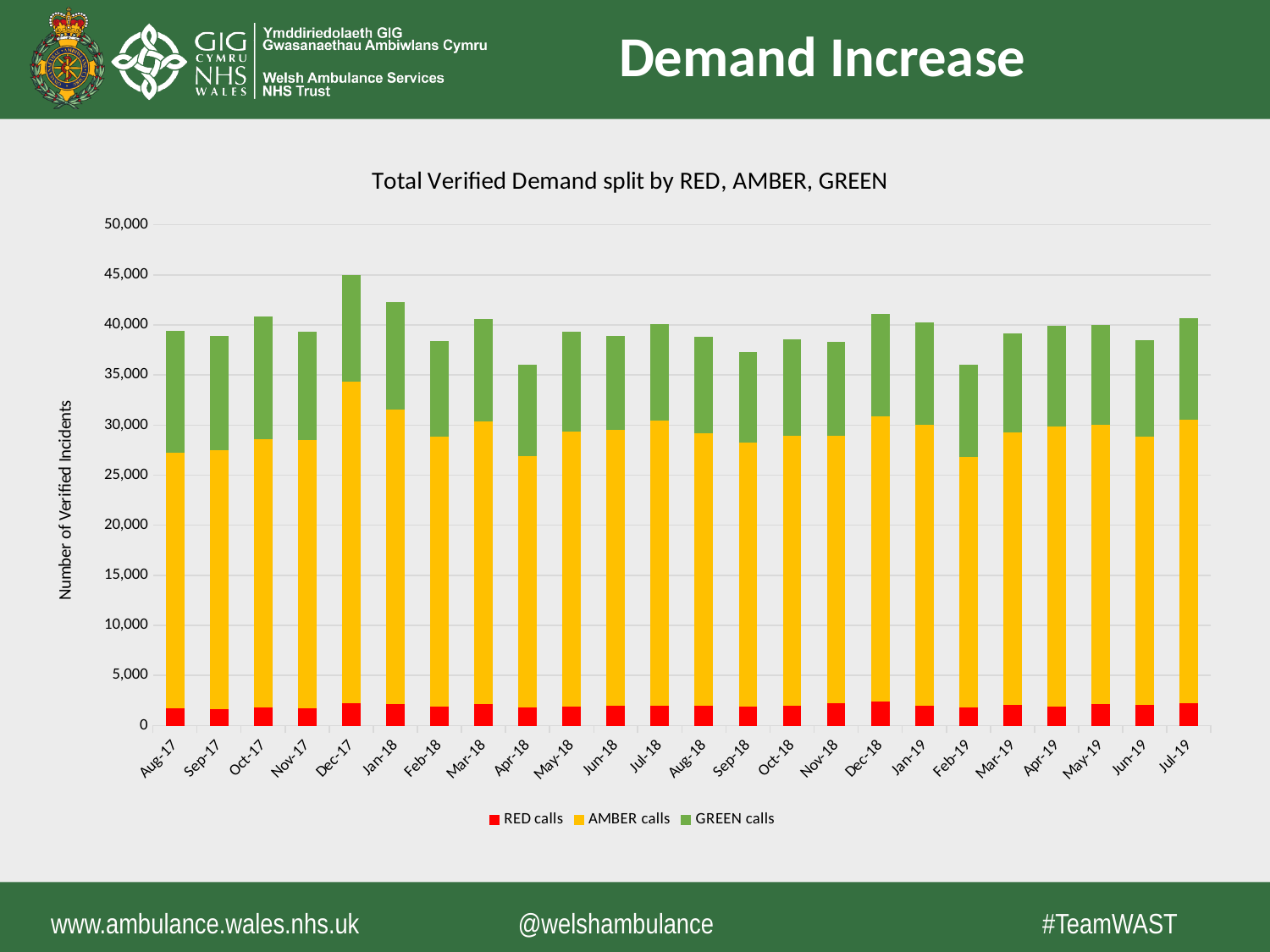
What kind of chart is shown on the slide? Stacked bar chart How many series does the legend list? 3 What are the three series named in the legend? RED calls, AMBER calls, GREEN calls Is the total for Apr-18 greater or less than 40,000? less Is the total for Feb-19 greater or less than 35,000? greater Is the total for Sep-18 greater or less than 40,000? less Which month has the larger total, Dec-17 or Jan-18? Dec-17 Which month has the larger total, Dec-17 or Apr-18? Dec-17 What is the title of the chart? Total Verified Demand split by RED, AMBER, GREEN How many months are shown along the x axis? 24 Which month has the highest total verified demand? Dec-17